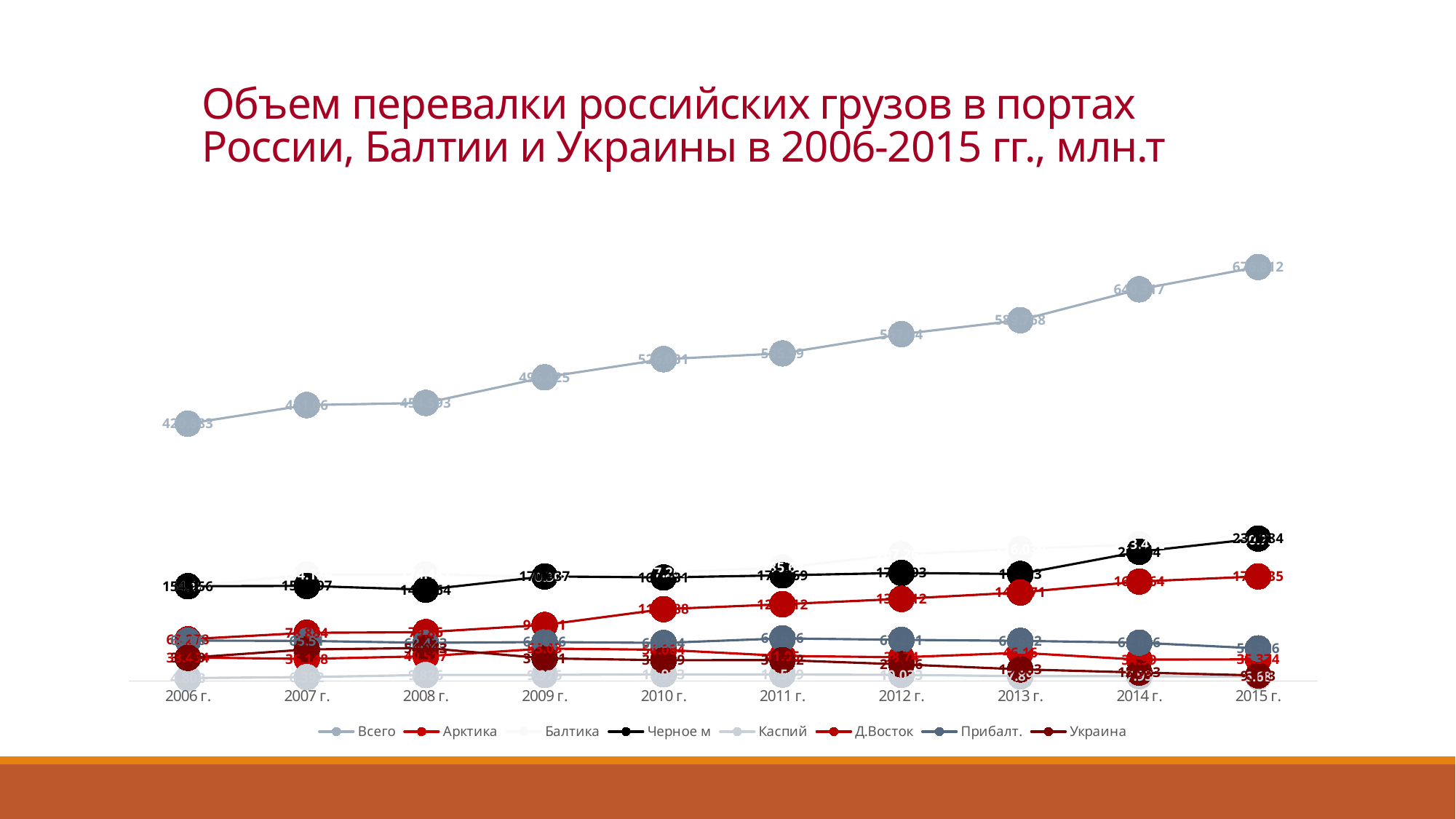
How many series does the legend list? 8 Do the values for Всего rise or fall from 2006 г. to 2015 г.? rise What kind of chart is shown on the slide? line chart How many years are plotted along the x axis? 10 Do the values for Украина rise or fall from 2006 г. to 2015 г.? fall In 2015 г., which is larger: the value for Всего or the value for Черное м? Всего In 2015 г., which is larger: the value for Арктика or the value for Прибалт.? Прибалт. Which series has the highest values across all years? Всего What is the first year shown on the x axis? 2006 г. What unit of measurement is given in the chart title? млн.т